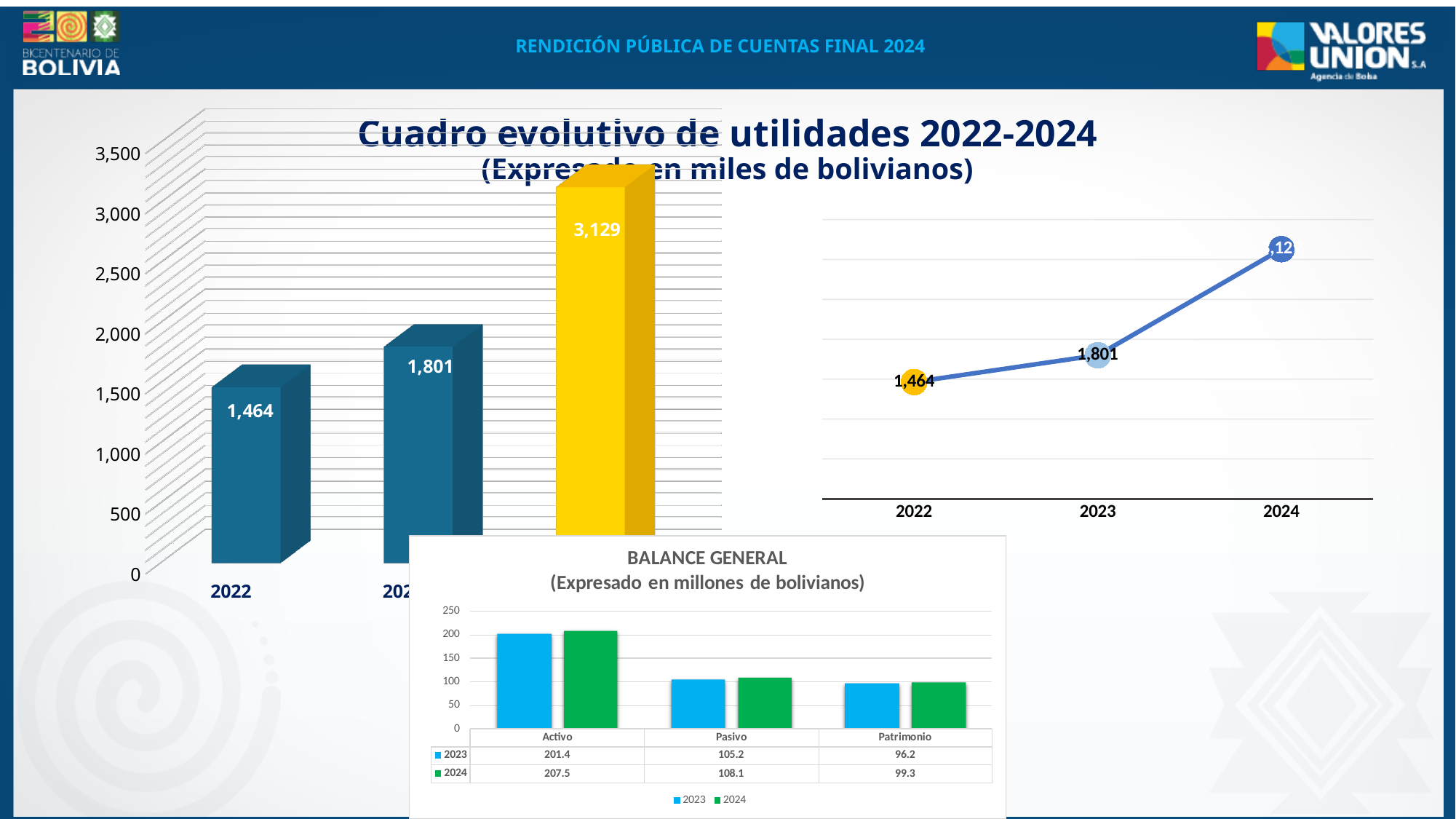
In the line chart on the right, what is the value for 2023? 1,801 In the line chart on the right, how many data points are plotted? 3 In the 'BALANCE GENERAL' chart, what is the value of Pasivo for 2023? 105.2 In the 'BALANCE GENERAL' chart, what is the value of Activo for 2024? 207.5 In the 'Cuadro evolutivo de utilidades 2022-2024' bar chart, what is the value for 2022? 1,464 In the 'BALANCE GENERAL' chart, how many series does the legend list? 2 In the 'Cuadro evolutivo de utilidades 2022-2024' bar chart, what value is printed on the yellow bar? 3,129 In the line chart on the right, do the values rise or fall from 2022 to 2024? rise In the 'BALANCE GENERAL' chart, what is the difference between Patrimonio in 2024 and Patrimonio in 2023? 3.1 In the 'Cuadro evolutivo de utilidades 2022-2024' bar chart, what is the difference between the yellow bar's value and the 2022 value? 1,665 In the 'BALANCE GENERAL' chart, which category has the lowest value for 2024? Patrimonio What kind of chart is the 'BALANCE GENERAL' chart? bar chart